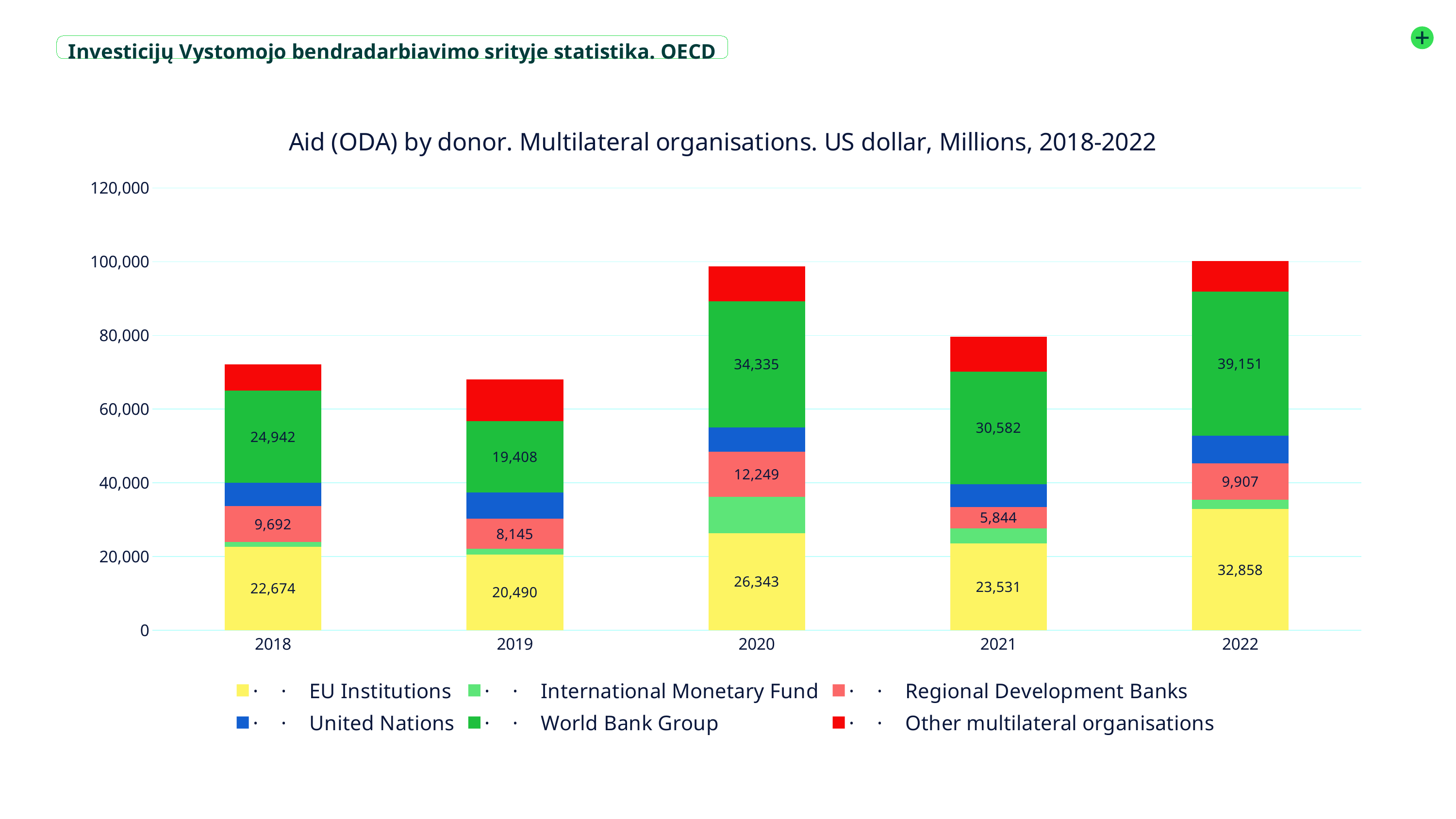
What is the difference between the World Bank Group values in 2022 and 2021? 8,569 What is the value for EU Institutions in 2022? 32,858 In which year is the World Bank Group value highest? 2022 How many series does the legend list? 6 Is the total stacked bar for 2018 greater or less than 60,000? greater How many years are shown on the x axis? 5 Which is larger in 2019: the EU Institutions value or the World Bank Group value? EU Institutions What is the value for World Bank Group in 2020? 34,335 Which series is shown in red in the legend? Other multilateral organisations In which year is the EU Institutions value lowest? 2019 What type of chart is shown on the slide? stacked bar chart What is the value for Regional Development Banks in 2021? 5,844